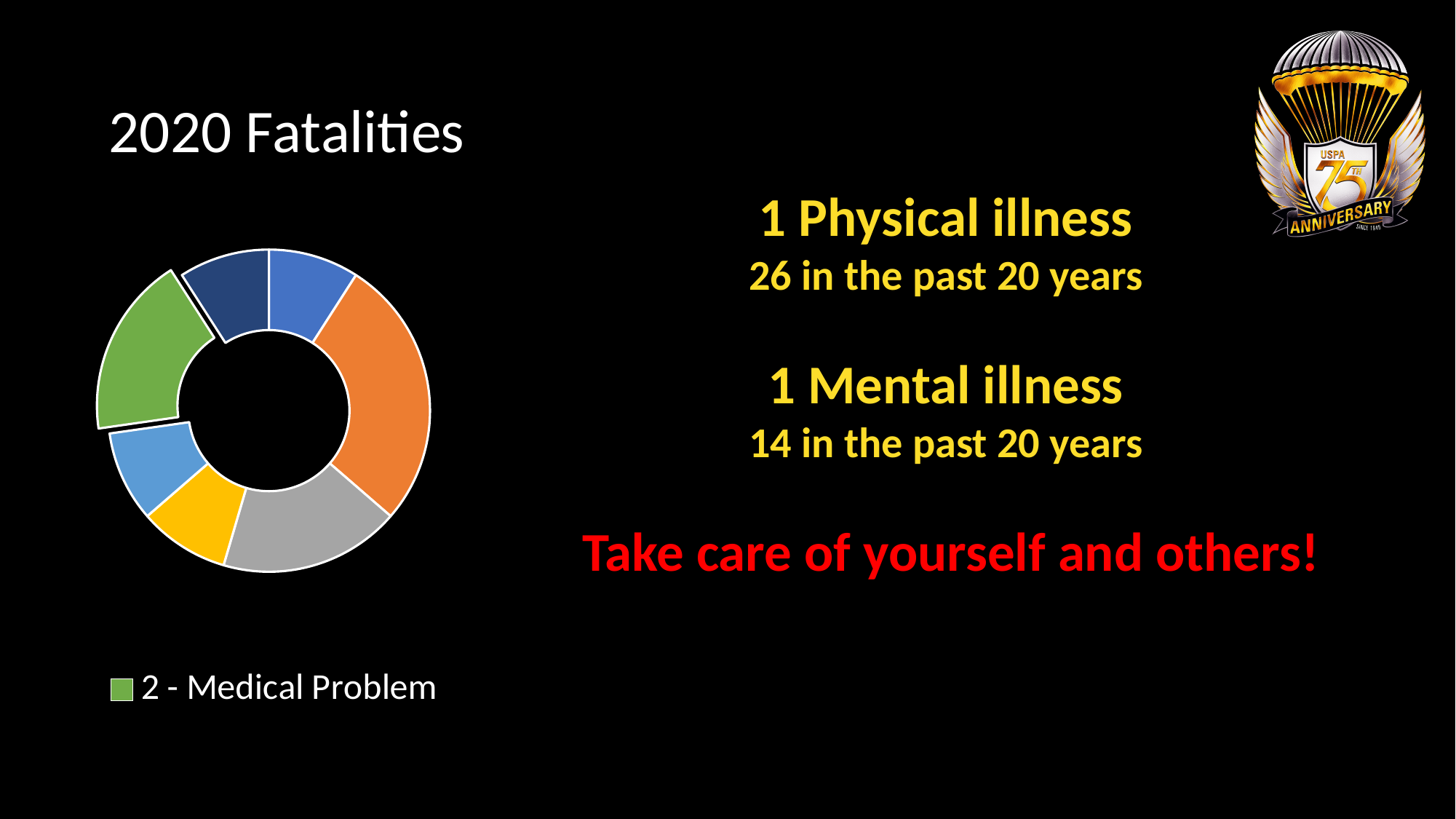
Which is larger, the grey slice or the yellow slice? Grey Which is larger, the orange slice or the green (Medical Problem) slice? Orange Which category is named in the chart's legend? 2 - Medical Problem What kind of chart is shown on the slide? Doughnut chart What is the title of the chart on the slide? 2020 Fatalities Which colour slice is the largest in the doughnut chart? Orange Which is larger, the green (Medical Problem) slice or the yellow slice? Green How many slices does the doughnut chart have? 7 How many fatalities does the legend attribute to Medical Problem? 2